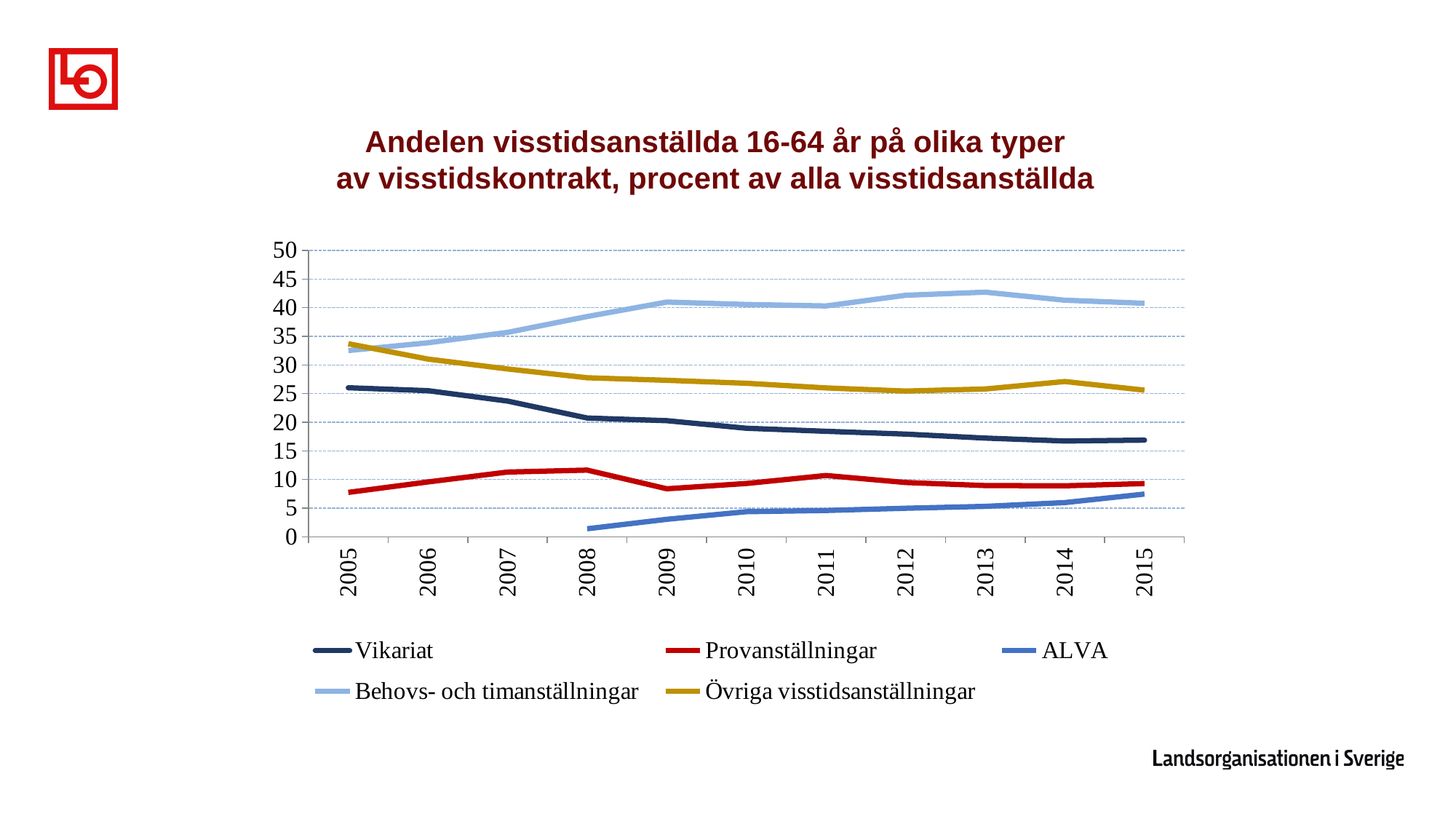
Which series has the highest value in 2015? Behovs- och timanställningar Does the Behovs- och timanställningar line rise or fall from 2005 to 2015? rise How many series does the legend list? 5 Is the value for Vikariat in 2015 greater or less than 20? less In 2015, which is larger: Övriga visstidsanställningar or Vikariat? Övriga visstidsanställningar Does the Övriga visstidsanställningar line rise or fall from 2005 to 2015? fall Is the value for Provanställningar in 2009 greater or less than 10? less Is the value for Behovs- och timanställningar in 2013 greater or less than 40? greater Which series has the lowest value in 2015? ALVA What kind of chart is shown on the slide? line chart Does the Vikariat line rise or fall from 2005 to 2015? fall How many years are shown on the x axis? 11